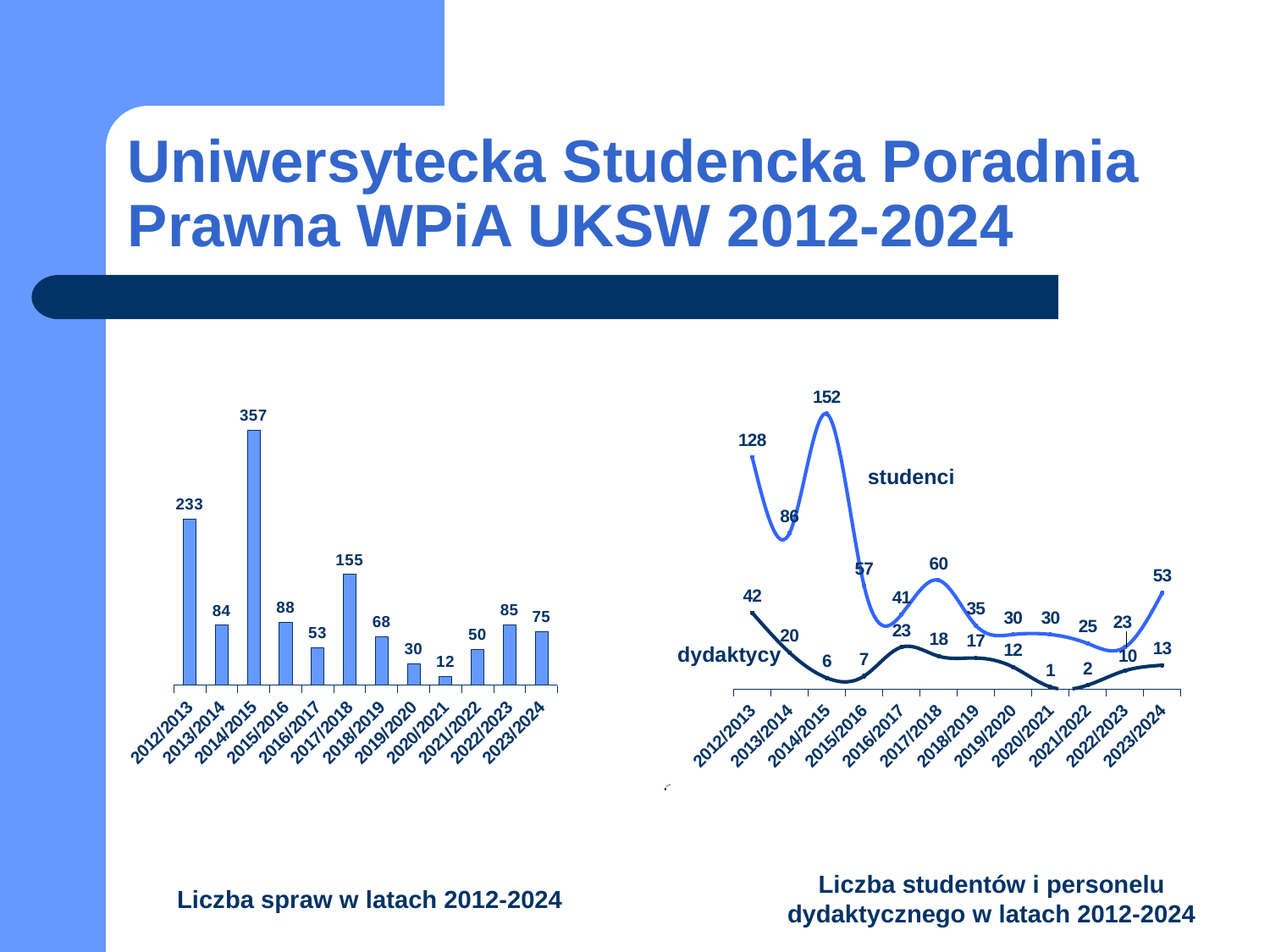
What kind of chart is the left chart (Liczba spraw w latach 2012-2024)? bar chart In the right chart (Liczba studentów i personelu dydaktycznego), what is the value for studenci in 2014/2015? 152 In the right chart (Liczba studentów i personelu dydaktycznego), which is larger in 2023/2024: studenci or dydaktycy? studenci In the right chart (Liczba studentów i personelu dydaktycznego), what is the difference between studenci and dydaktycy in 2012/2013? 86 In the left chart (Liczba spraw w latach 2012-2024), which year has the lowest value? 2020/2021 In the left chart (Liczba spraw w latach 2012-2024), what is the difference between the values for 2012/2013 and 2013/2014? 149 In the left chart (Liczba spraw w latach 2012-2024), what is the value for 2014/2015? 357 How many series are plotted in the right chart (Liczba studentów i personelu dydaktycznego)? 2 In the left chart (Liczba spraw w latach 2012-2024), how many years are shown on the x axis? 12 What kind of chart is the right chart (Liczba studentów i personelu dydaktycznego)? line chart In the left chart (Liczba spraw w latach 2012-2024), which year has the highest value? 2014/2015 In the right chart (Liczba studentów i personelu dydaktycznego), what is the value for dydaktycy in 2020/2021? 1